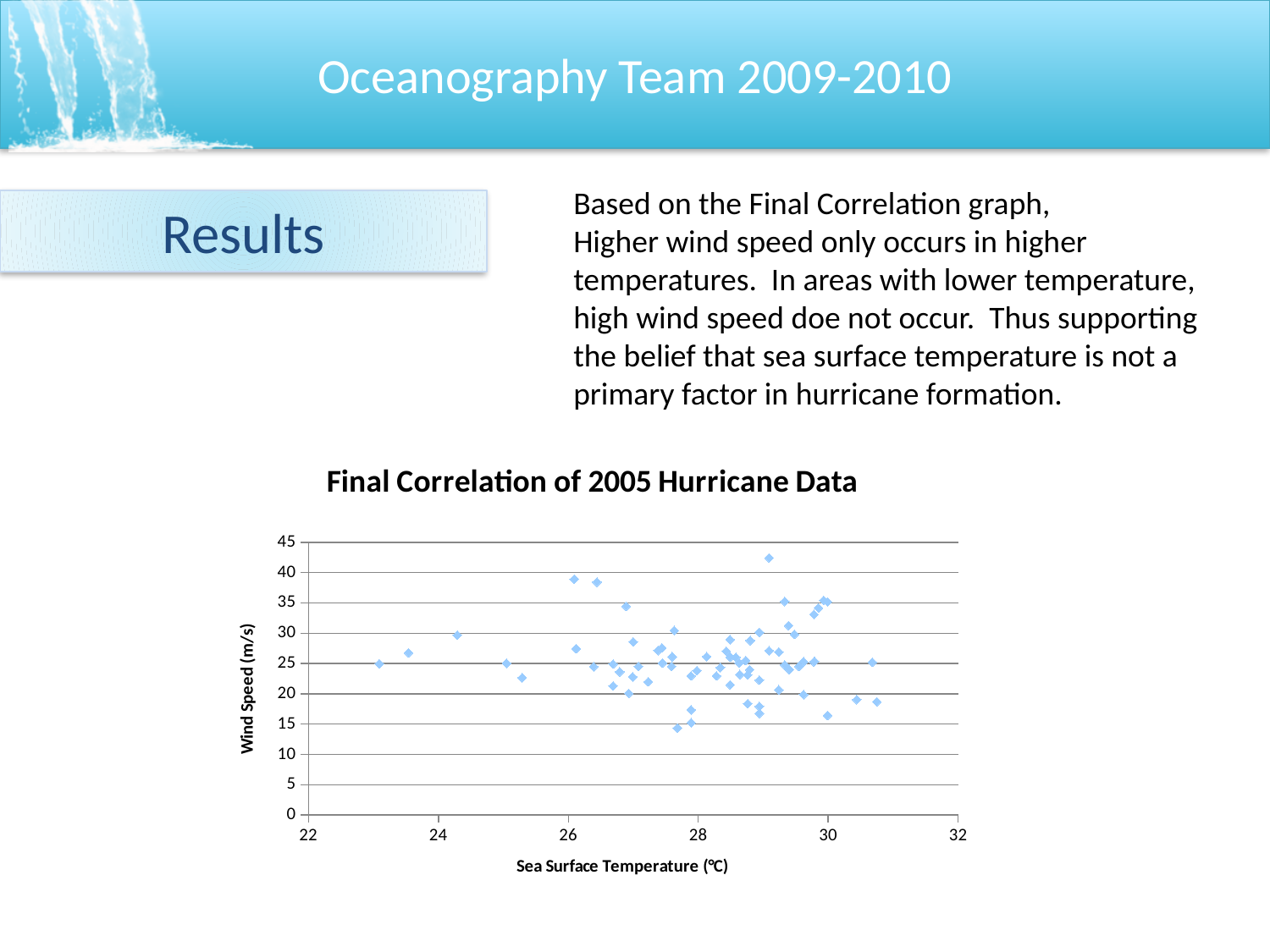
Is the sea surface temperature of the point with the highest wind speed greater or less than 28? greater What is the title of the chart? Final Correlation of 2005 Hurricane Data Is the highest sea surface temperature plotted on the chart greater or less than 30? greater Is the highest wind speed plotted on the chart greater or less than 40? greater What is the label of the horizontal axis of the chart? Sea Surface Temperature (°C) What kind of chart is shown on the slide? scatter chart